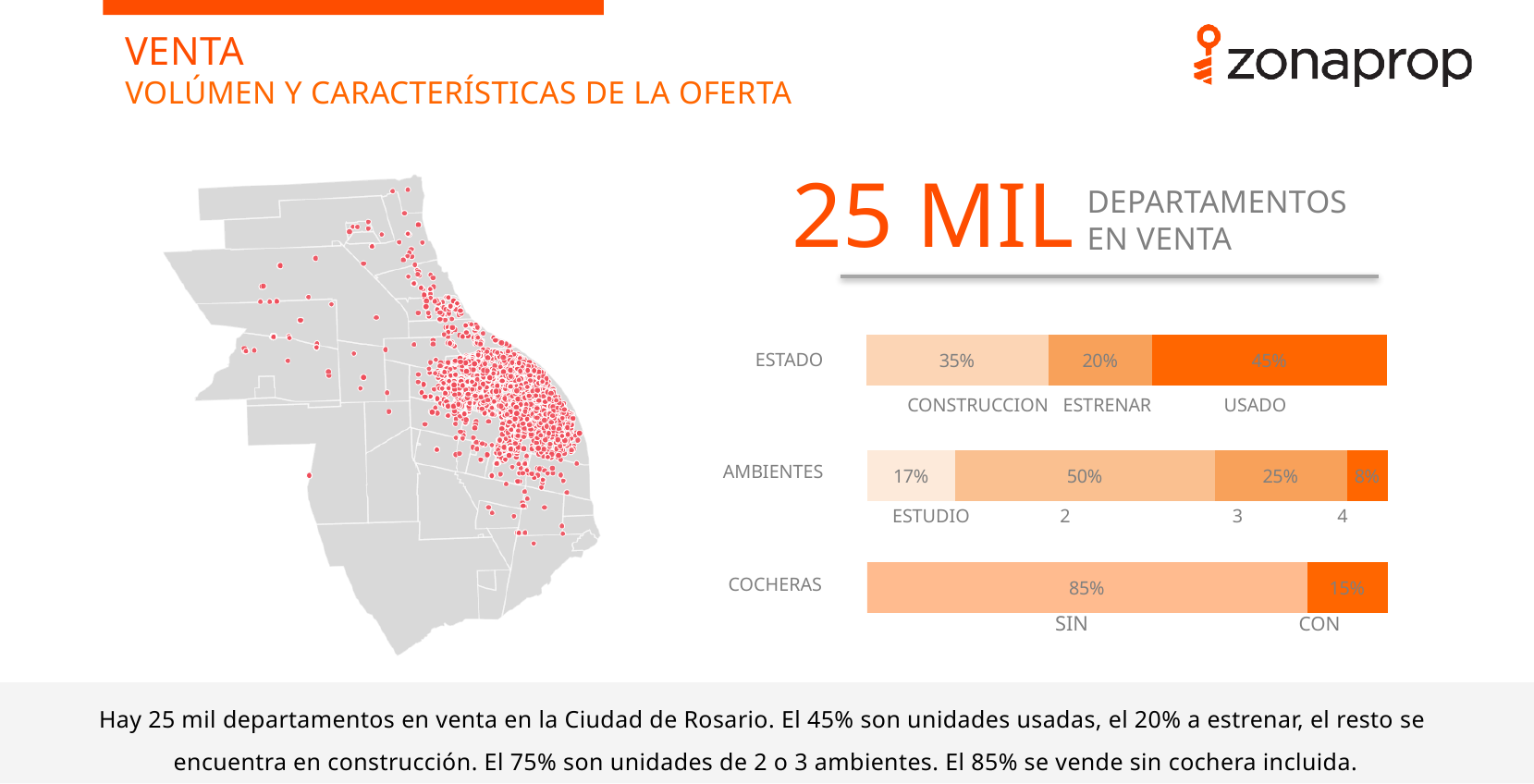
In the ESTADO bar, what percentage of apartments for sale are in CONSTRUCCION? 35% In the ESTADO bar, what is the difference between the USADO share and the ESTRENAR share? 25% In the AMBIENTES bar, what percentage of apartments have 2 ambientes? 50% In the AMBIENTES bar, what percentage of apartments are ESTUDIO? 17% In the ESTADO bar, which category has the largest share? USADO In the AMBIENTES bar, which is larger: the share for 3 ambientes or the share for ESTUDIO? 3 How many segments does the AMBIENTES bar have? 4 In the ESTADO bar, what percentage of apartments for sale are USADO? 45% What kind of chart is used to show ESTADO, AMBIENTES and COCHERAS? Stacked bar chart In the COCHERAS bar, what percentage of apartments are sold SIN cochera? 85% In the AMBIENTES bar, which category has the smallest share? 4 In the COCHERAS bar, what is the combined total of the SIN and CON segments? 100%